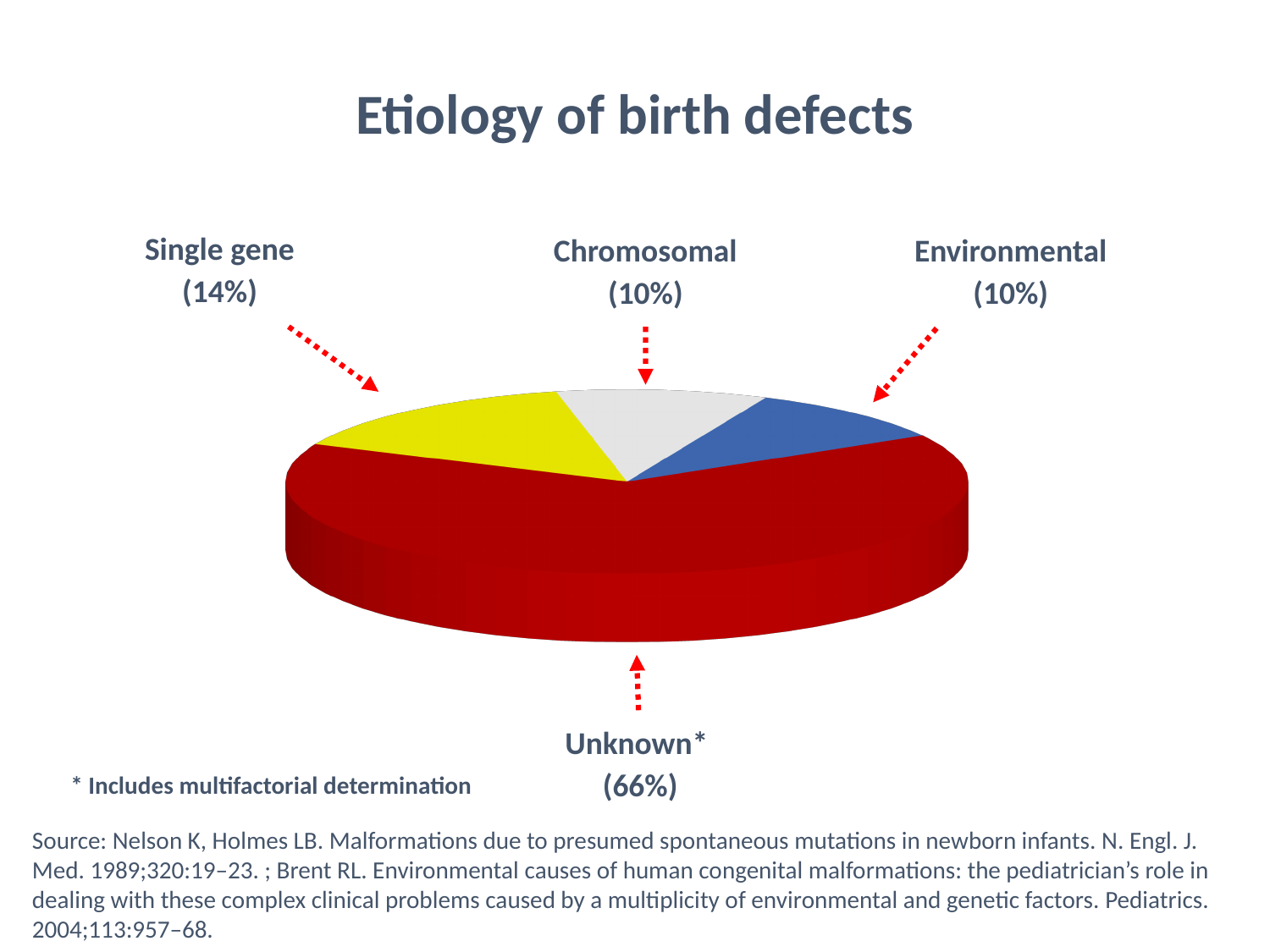
What is the difference in percentage points between the Unknown and Single gene shares? 52 What kind of chart is shown on the slide? Pie chart What share of birth defects is attributed to Chromosomal causes? 10% What share of birth defects is attributed to Unknown causes? 66% What share of birth defects is attributed to Environmental causes? 10% How many categories are shown in the pie chart? 4 What is the title of the chart? Etiology of birth defects What is the difference in percentage points between the Single gene and Chromosomal shares? 4 Which category accounts for the largest share of birth defects? Unknown Which is larger, the Single gene share or the Environmental share? Single gene What colour is the Unknown slice of the pie chart? Red